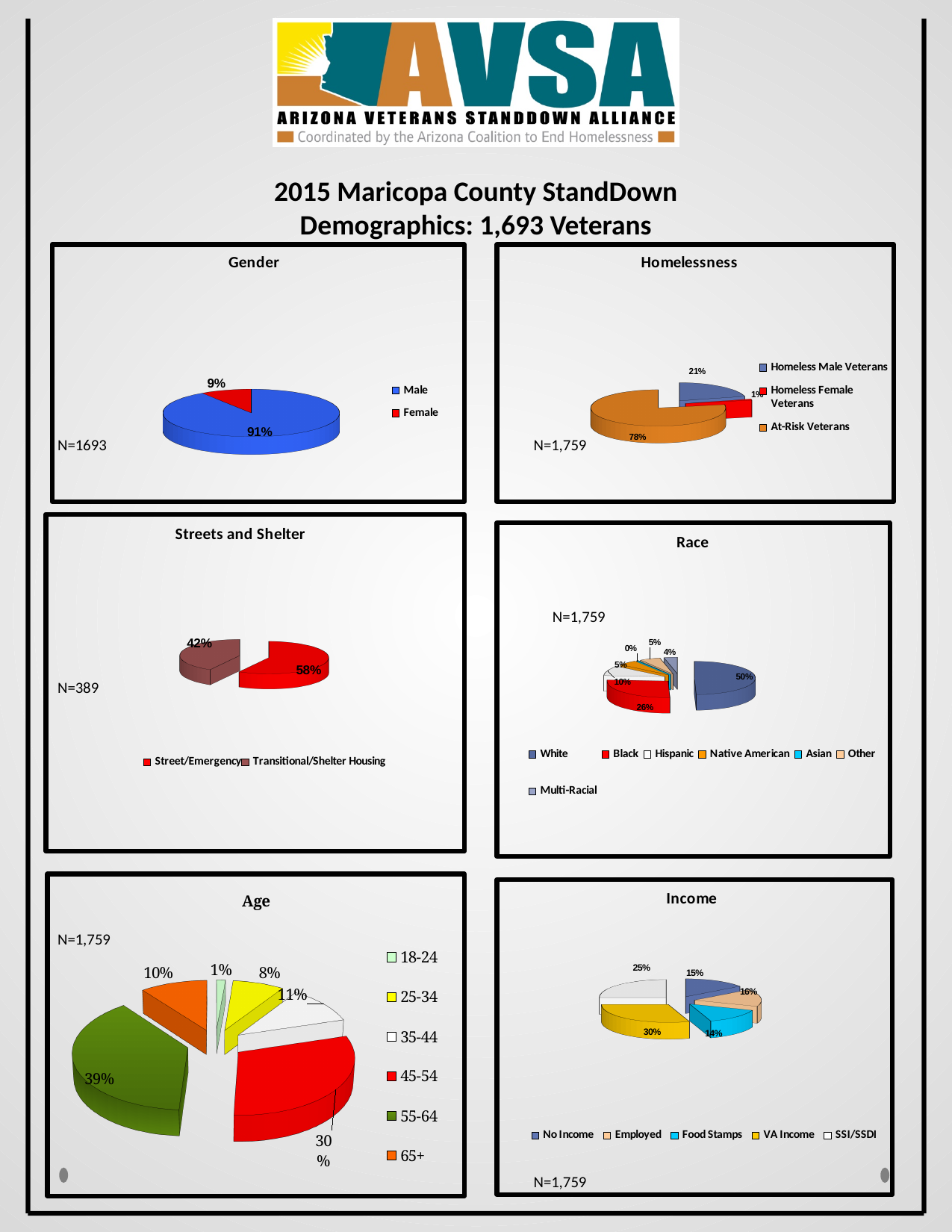
In the Race chart, what is the value for White? 50% In the Income chart, what is the value for SSI/SSDI? 25% What kind of chart is the Gender chart? Pie chart In the Age chart, which age group has the largest share? 55-64 In the Age chart, what is the value for 45-54? 30% How many series does the legend of the Race chart list? 7 In the Streets and Shelter chart, which is larger, Street/Emergency or Transitional/Shelter Housing? Street/Emergency In the Age chart, what is the difference between the 55-64 and 45-54 shares? 9 percentage points In the Homelessness chart, what is the value for At-Risk Veterans? 78% In the Gender chart, what share of the pie is Male? 91% In the Income chart, which category has the largest share? VA Income In the Homelessness chart, what is the value for Homeless Male Veterans? 21%